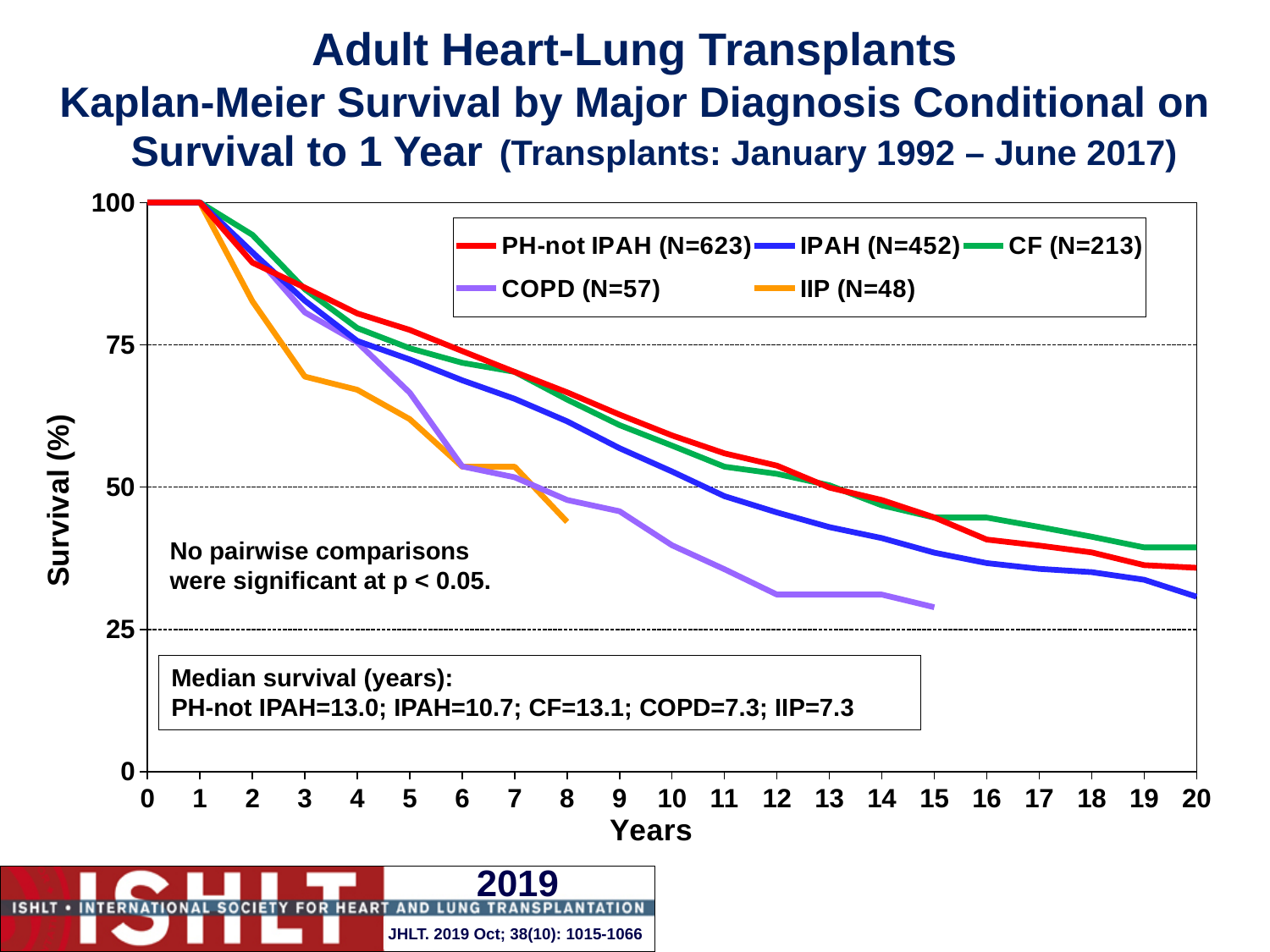
Is the survival value for COPD at 12 years greater or less than 50? less What is the N for the COPD series shown in the legend? 57 At 20 years, which series has the higher survival, CF or IPAH? CF Is the survival value for CF at 20 years greater or less than 25? greater What is the difference in median survival (years) between PH-not IPAH and IPAH? 2.3 Do the survival curves rise or fall as years increase along the x axis? Fall What kind of chart is shown on the slide? Line chart What is the median survival in years for CF according to the text box on the chart? 13.1 How many series does the legend list? 5 Which diagnosis group has the largest N in the legend? PH-not IPAH (N=623) What is the median survival in years for IPAH according to the text box on the chart? 10.7 Which diagnosis group has the longest median survival listed in the text box? CF